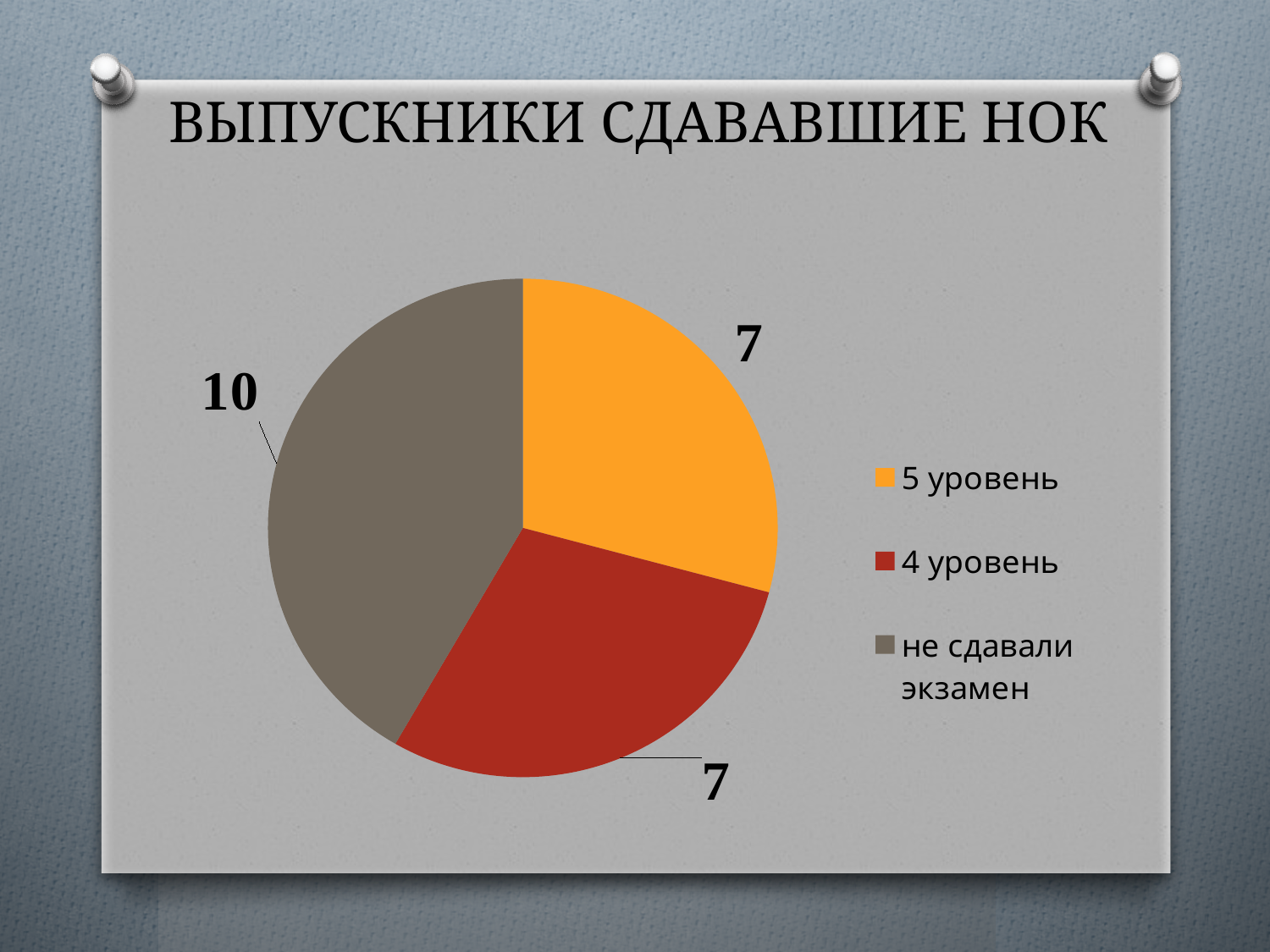
What is the difference between the value for "не сдавали экзамен" and the value for "5 уровень"? 3 How many entries does the legend list? 3 What is the value for the "4 уровень" slice? 7 Which is larger: the value for "не сдавали экзамен" or the value for "4 уровень"? не сдавали экзамен What is the total of all the slice values in the pie chart? 24 What is the title of the chart? ВЫПУСКНИКИ СДАВАВШИЕ НОК What type of chart is shown on the slide? Pie chart Which category has the largest slice of the pie? не сдавали экзамен What is the value for the "не сдавали экзамен" slice? 10 What is the value for the "5 уровень" slice? 7 How many slices does the pie chart have? 3 What colour is the "не сдавали экзамен" slice? Grey